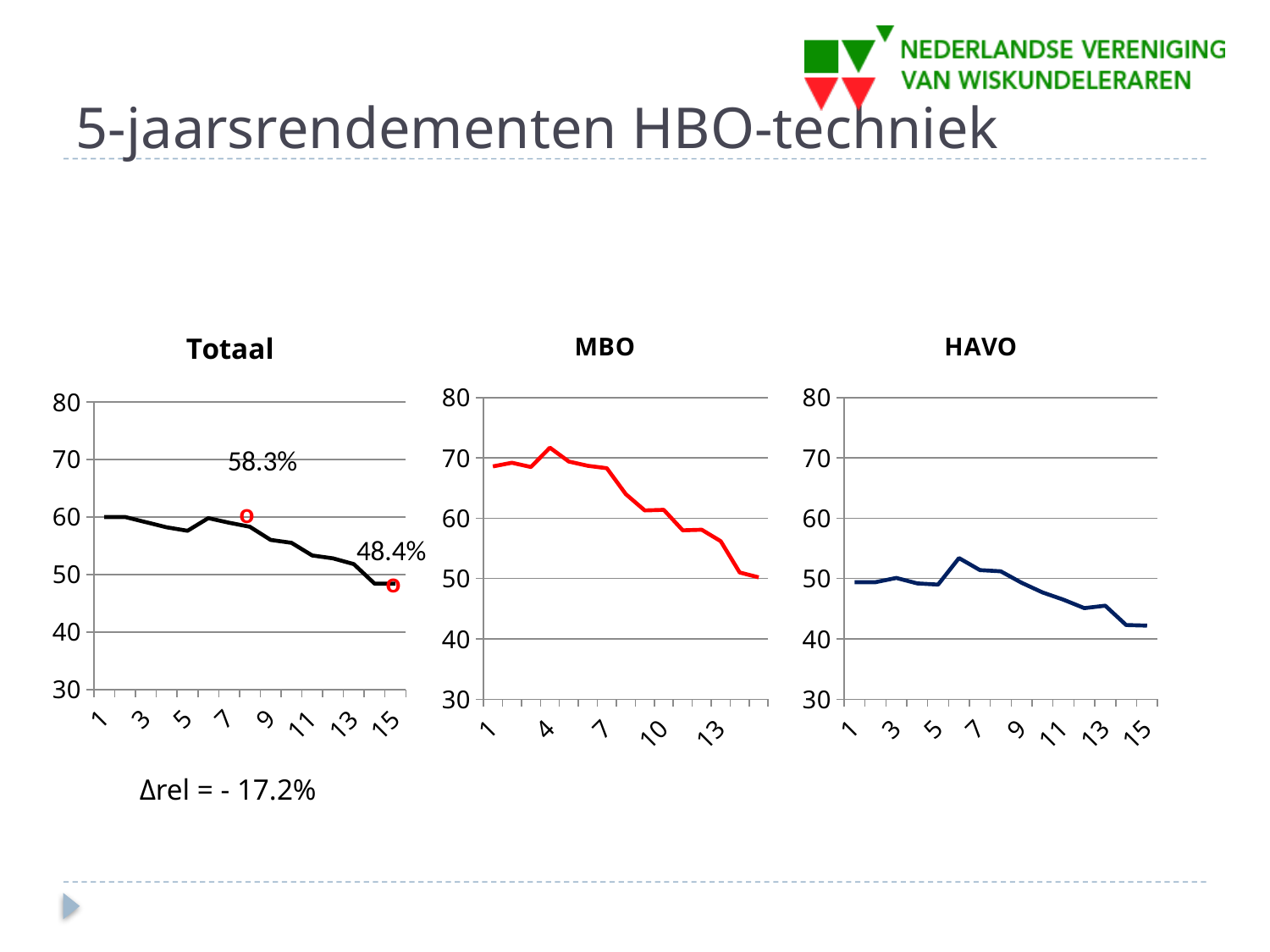
In the 'Totaal' chart, what value is labelled at point 8? 58.3% What colour is the line in the 'MBO' chart? red In the 'Totaal' chart, is the value at point 1 greater or less than 50? greater In the 'Totaal' chart, what is the difference between the labelled values 58.3% and 48.4%? 9.9% In the 'MBO' chart, is the value at point 1 greater or less than 60? greater In the 'MBO' chart, do the values rise or fall overall along the x axis? fall How many points are plotted on the x axis of the 'HAVO' chart? 15 In the 'HAVO' chart, is the value at point 15 greater or less than 50? less In the 'MBO' chart, at which x-axis point is the value highest? 4 In the 'Totaal' chart, do the values rise or fall from point 1 to point 15? fall What kind of chart is the 'Totaal' chart? line chart In the 'Totaal' chart, what value is labelled at point 15? 48.4%